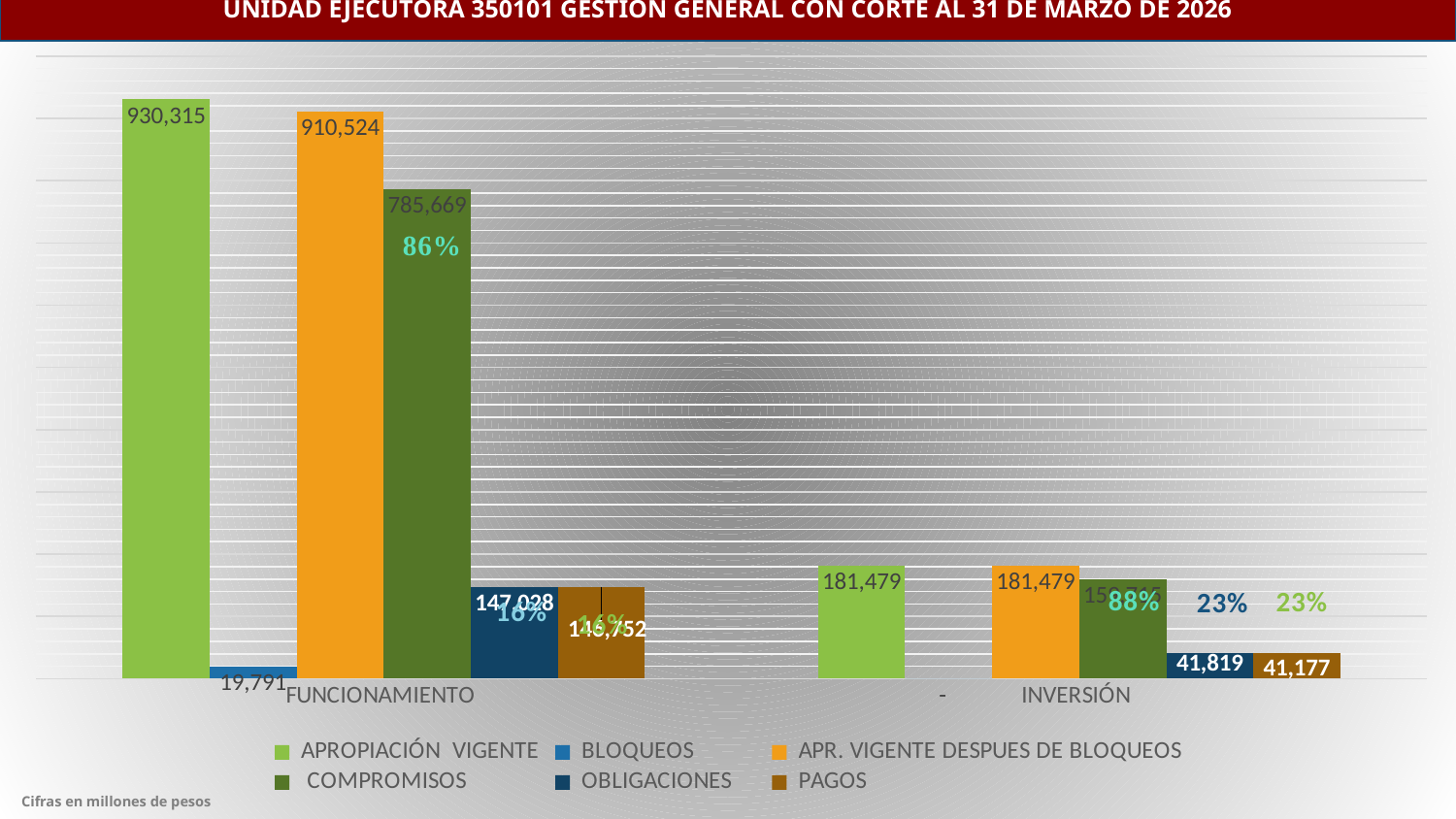
What is the value of APROPIACIÓN VIGENTE for INVERSIÓN? 181,479 What is the value of APROPIACIÓN VIGENTE for FUNCIONAMIENTO? 930,315 What kind of chart is shown on the slide? Bar chart What is the value of COMPROMISOS for FUNCIONAMIENTO? 785,669 What is the difference between APROPIACIÓN VIGENTE and APR. VIGENTE DESPUES DE BLOQUEOS for FUNCIONAMIENTO? 19,791 What is the value of OBLIGACIONES for INVERSIÓN? 41,819 How many categories are shown on the x axis? 2 How many series does the legend list? 6 What is the value of PAGOS for INVERSIÓN? 41,177 What is the value of APR. VIGENTE DESPUES DE BLOQUEOS for FUNCIONAMIENTO? 910,524 Which series has the highest value for FUNCIONAMIENTO? APROPIACIÓN VIGENTE What is the value of BLOQUEOS for FUNCIONAMIENTO? 19,791